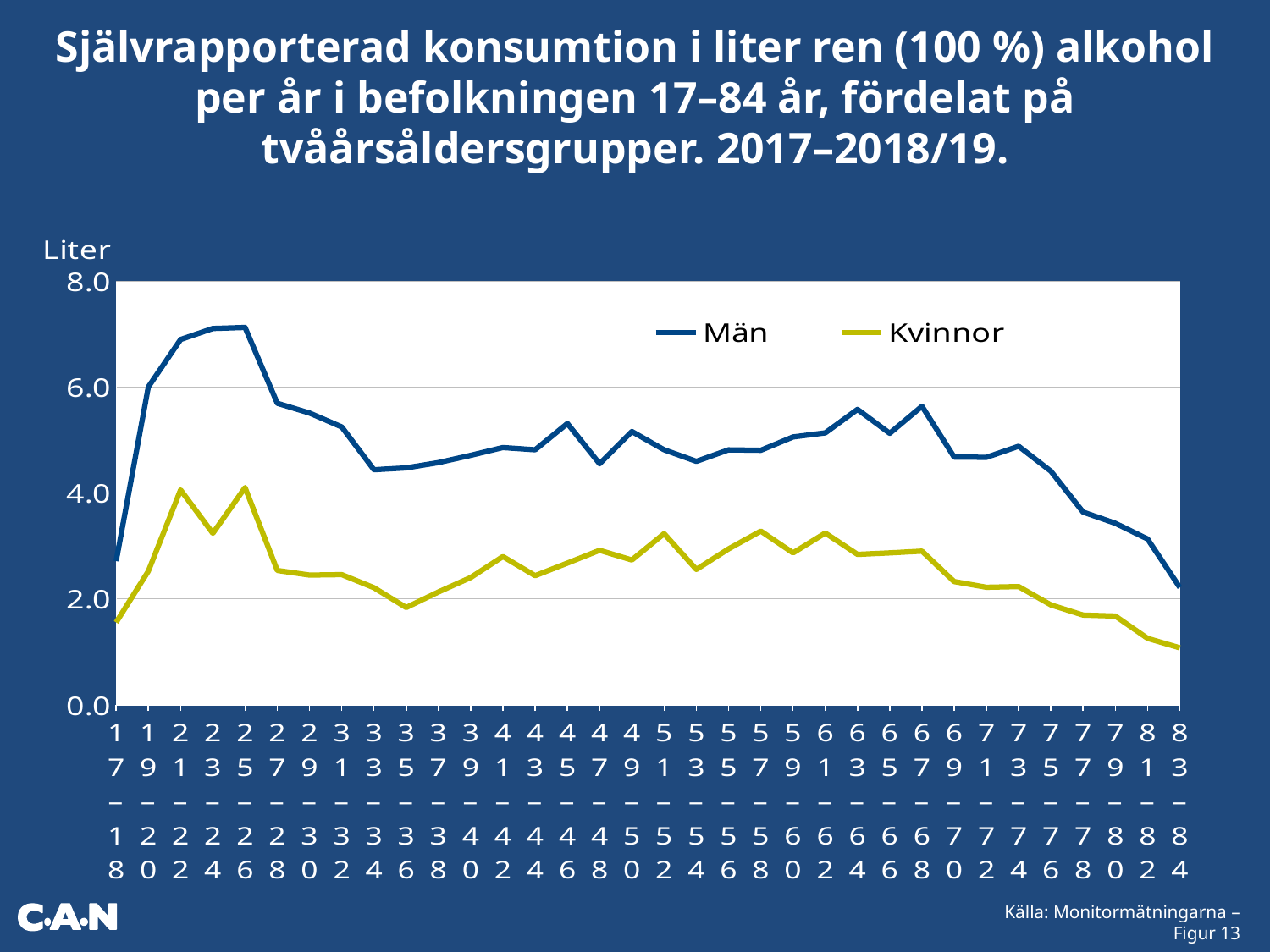
Is the value for Kvinnor in the 83–84 age group greater or less than 2.0? less What are the two series named in the legend? Män and Kvinnor How many series does the legend list? 2 How many two-year age groups are plotted along the x axis? 34 Is the value for Män in the 25–26 age group greater or less than 6.0? greater Is the value for Män in the 45–46 age group greater or less than 4.0? greater Do the values for Män rise or fall from the 67–68 age group to the 83–84 age group? Fall What kind of chart is shown on the slide? Line chart In the 25–26 age group, which series has the higher value, Män or Kvinnor? Män What is the label on the y axis? Liter